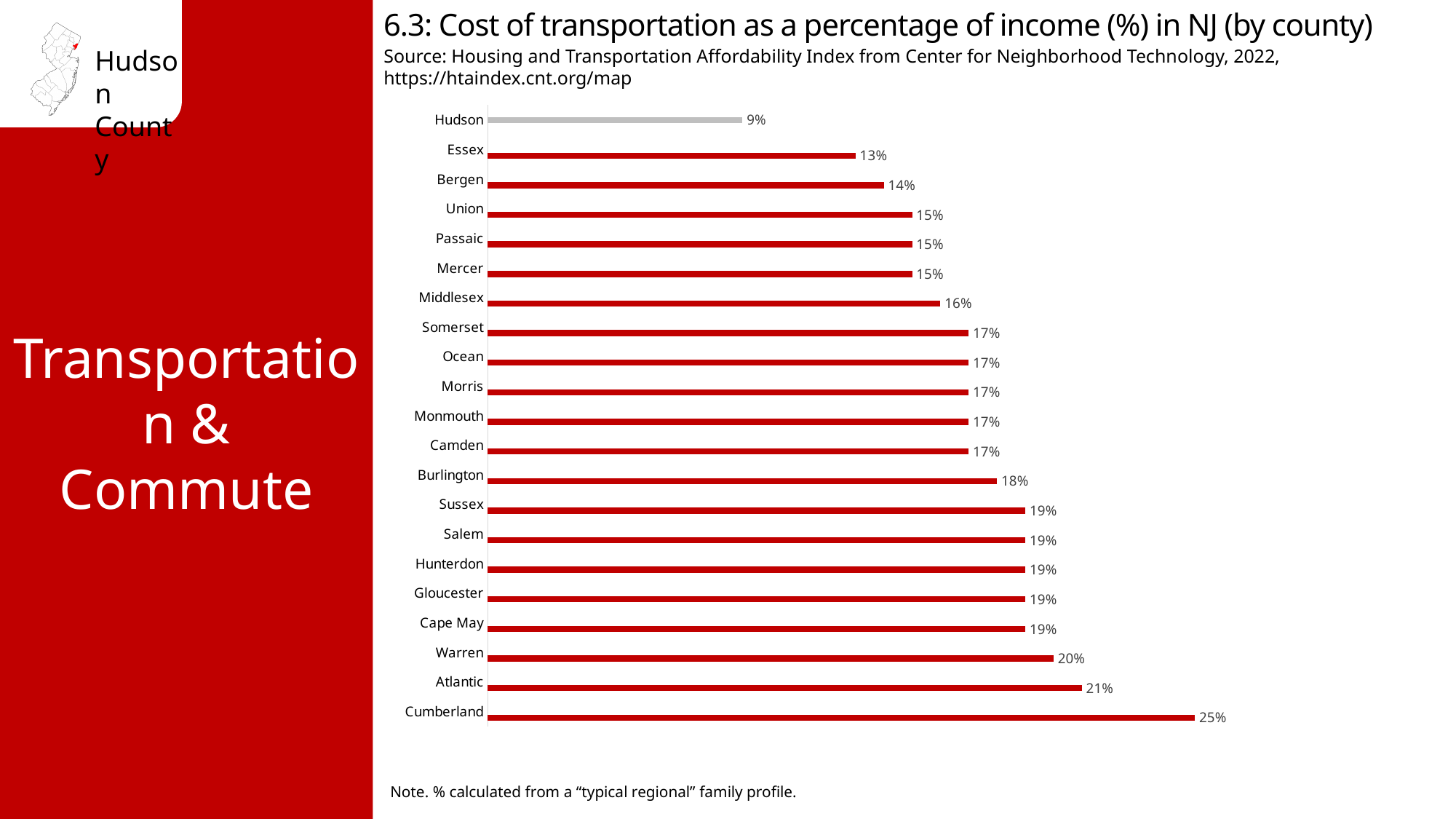
What kind of chart is shown on the slide? Bar chart What is the difference between the values for Atlantic and Essex? 8% What is the cost of transportation as a percentage of income for Cumberland County? 25% What is the value shown for Middlesex? 16% What is the cost of transportation as a percentage of income for Hudson County? 9% Which bar is shown in a different colour (grey) from the others? Hudson Which county has the highest cost of transportation as a percentage of income? Cumberland What is the value shown for Burlington? 18% What is the difference between the values for Cumberland and Hudson? 16% How many counties are shown in the chart? 21 Which county has the lowest cost of transportation as a percentage of income? Hudson Which has a higher value, Warren or Bergen? Warren